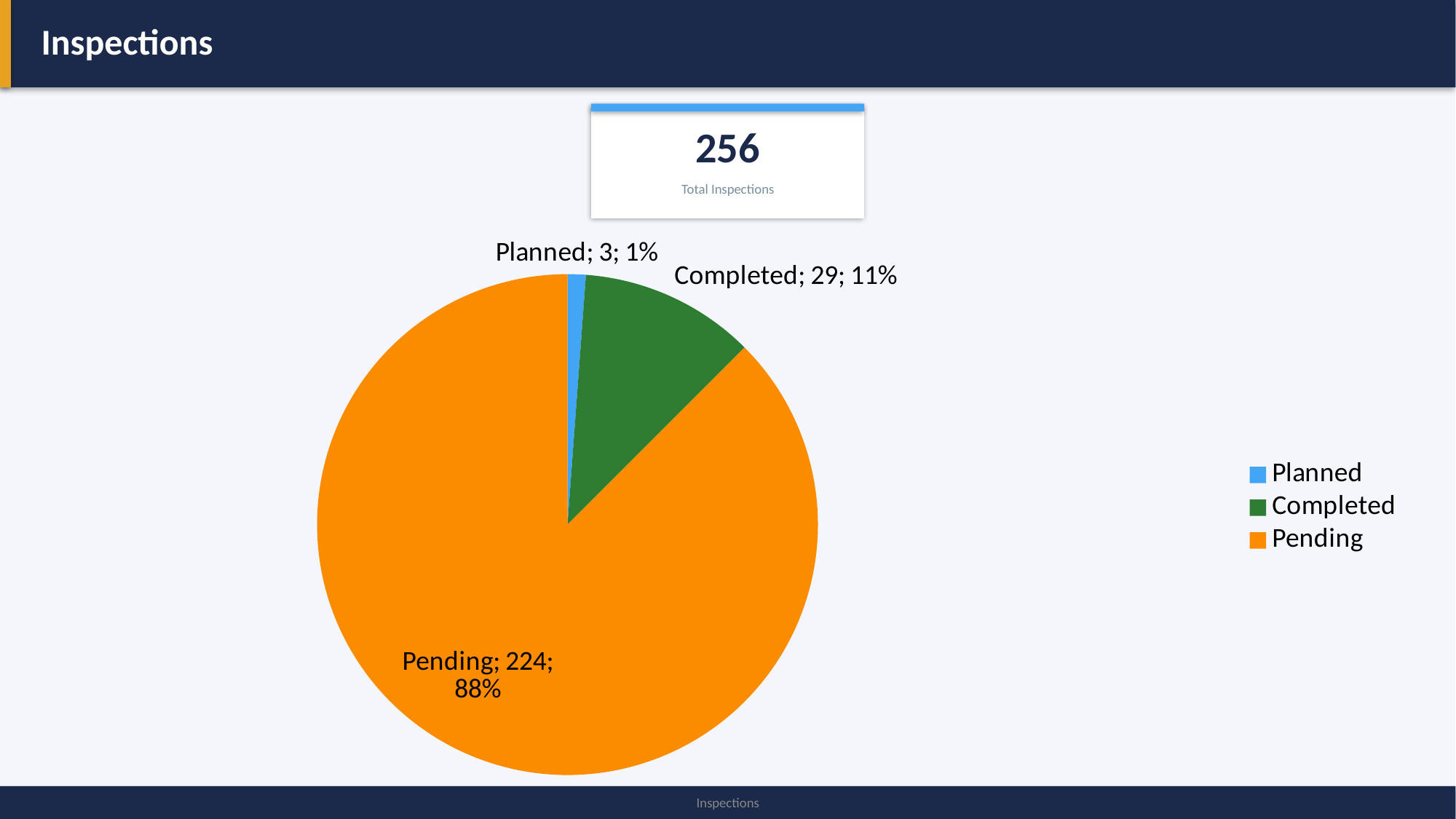
How many inspections are Pending? 224 What kind of chart is shown on the slide? pie chart What colour is the Pending slice? orange How many categories does the pie chart have? 3 Which category has the largest slice? Pending What share of the pie does the Completed slice represent? 11% How many inspections are Planned? 3 What is the difference between the Pending and Completed counts? 195 How many inspections are Completed? 29 Which is larger, Completed or Planned? Completed What share of the pie does the Pending slice represent? 88% Which category has the smallest slice? Planned